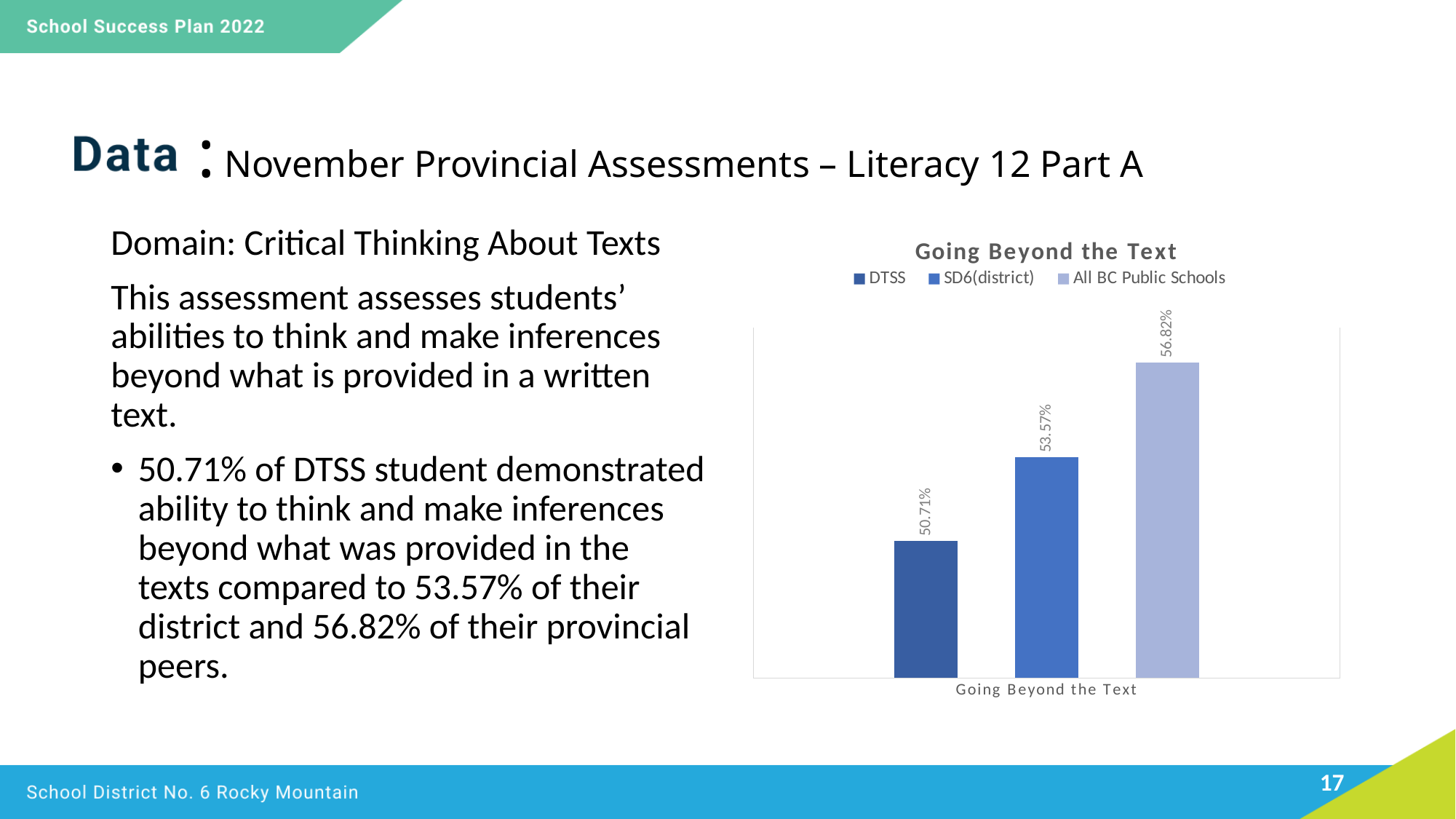
Which series has the lowest value in the Going Beyond the Text chart? DTSS How many series does the legend of the Going Beyond the Text chart list? 3 What is the value for SD6(district) in the Going Beyond the Text chart? 53.57% What is the value for All BC Public Schools in the Going Beyond the Text chart? 56.82% What is the difference between the SD6(district) value and the DTSS value in the Going Beyond the Text chart? 2.86% What is the value for DTSS in the Going Beyond the Text chart? 50.71% Which is larger in the Going Beyond the Text chart, the value for DTSS or the value for SD6(district)? SD6(district) What is the title of the chart on the slide? Going Beyond the Text What is the x-axis category label in the Going Beyond the Text chart? Going Beyond the Text What kind of chart is the Going Beyond the Text chart? Bar chart Which series has the highest value in the Going Beyond the Text chart? All BC Public Schools What is the difference between the All BC Public Schools value and the DTSS value in the Going Beyond the Text chart? 6.11%